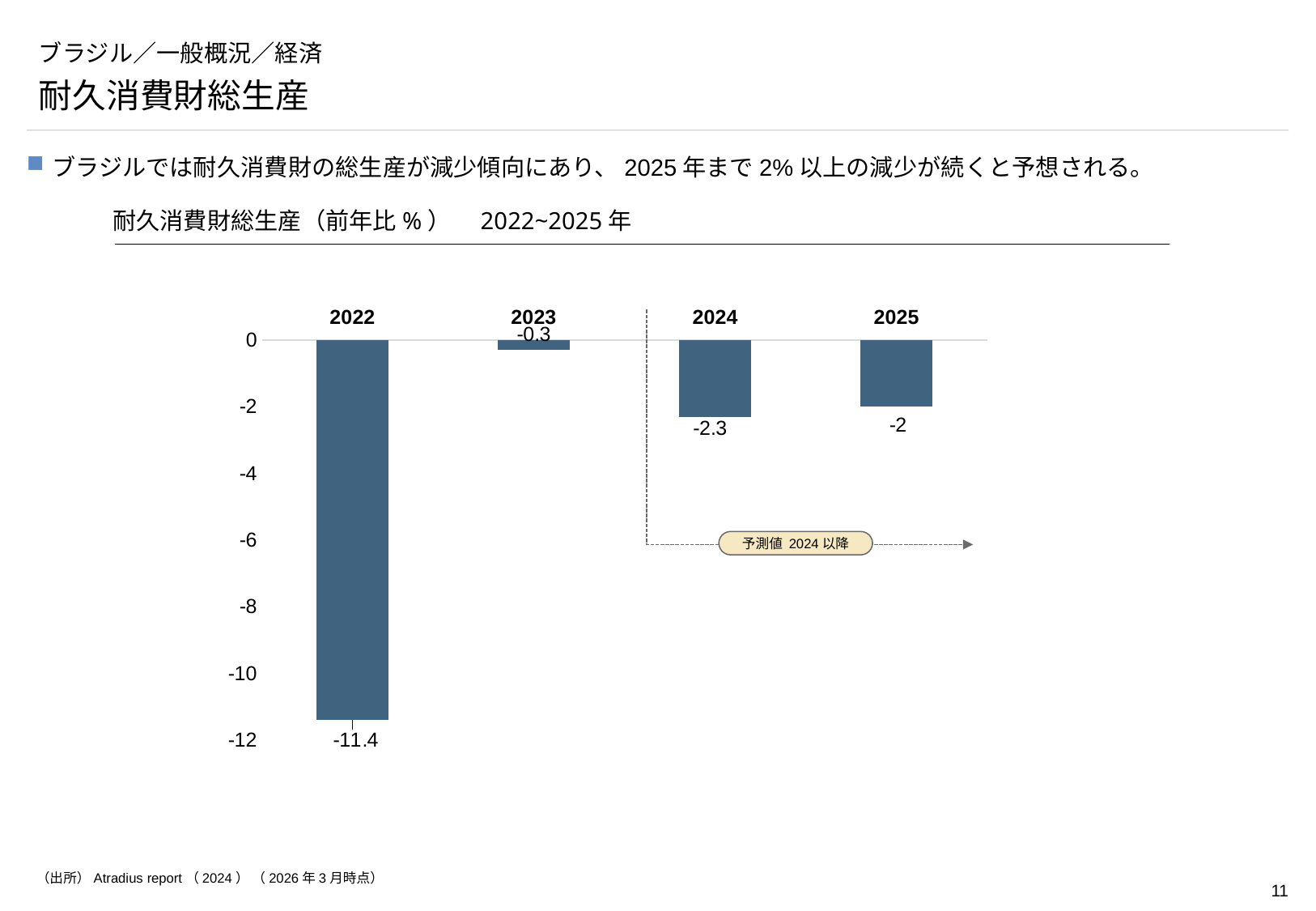
What is the value for 2024 in the chart? -2.3 What kind of chart is shown on the slide? Bar chart Which year has the lowest value in the chart? 2022 How many years are plotted in the chart? 4 What is the difference between the values for 2022 and 2023? 11.1 What is the difference between the values for 2024 and 2025? 0.3 What is the value for 2023 in the chart? -0.3 Which is larger, the value for 2024 or the value for 2025? 2025 What is the value for 2025 in the chart? -2 What is the value for 2022 in the chart? -11.4 Which year has the highest value in the chart? 2023 According to the annotation on the chart, from which year onward are the values forecasts (予測値)? 2024